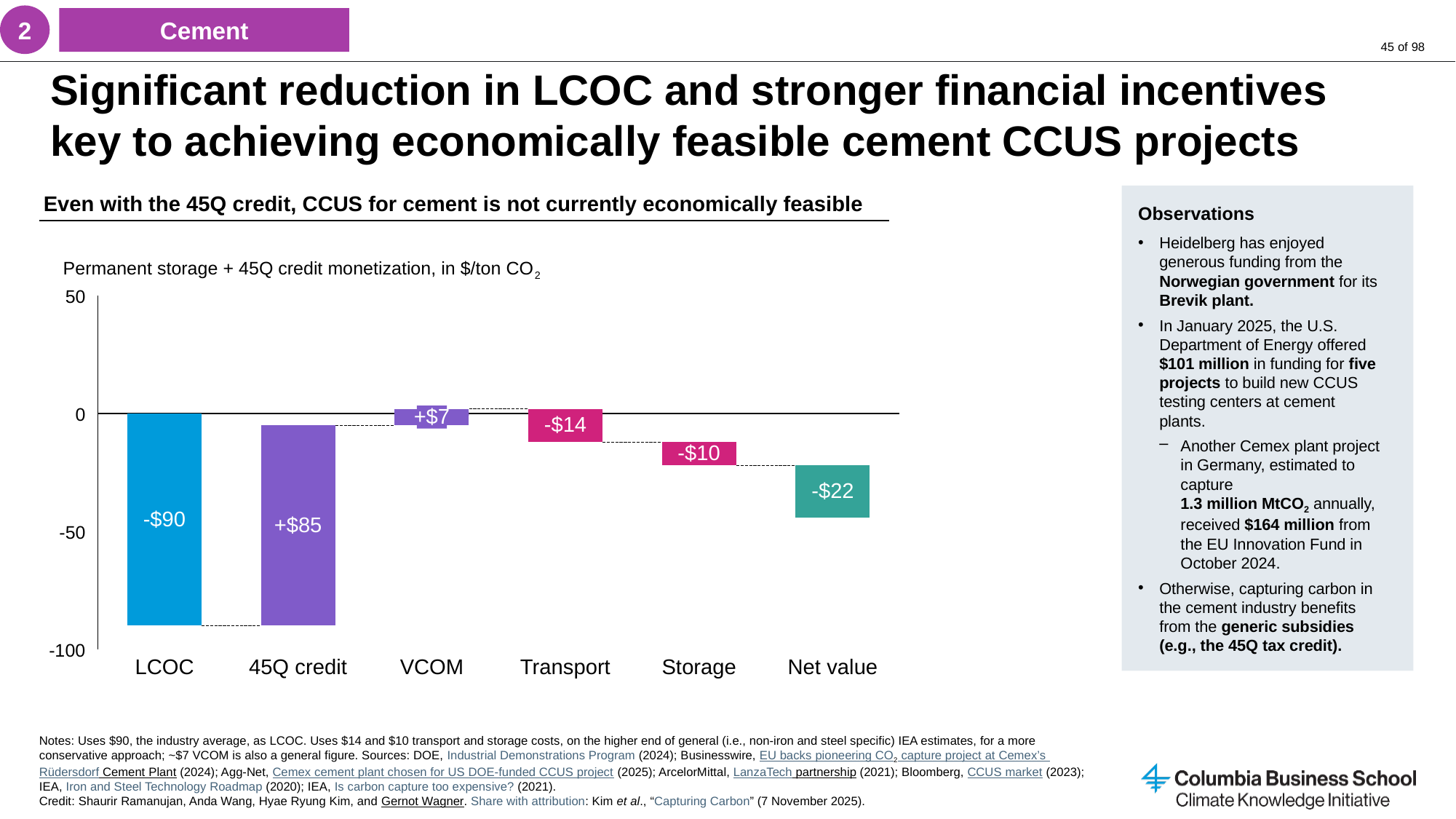
What is the value shown for Net value? -$22 Is the value for Net value greater or less than -50? greater Which category has the most negative value? LCOC What is the value shown for LCOC? -$90 Which is larger in magnitude, the LCOC value or the 45Q credit value? LCOC How many categories are shown on the x axis? 6 Which category has the largest positive value? 45Q credit What is the value shown for the 45Q credit? +$85 What is the value shown for Transport? -$14 What unit is the chart measured in, according to its subtitle? $/ton CO2 What is the difference between the Transport cost and the Storage cost? $4 What kind of chart is this? Bar chart (waterfall)